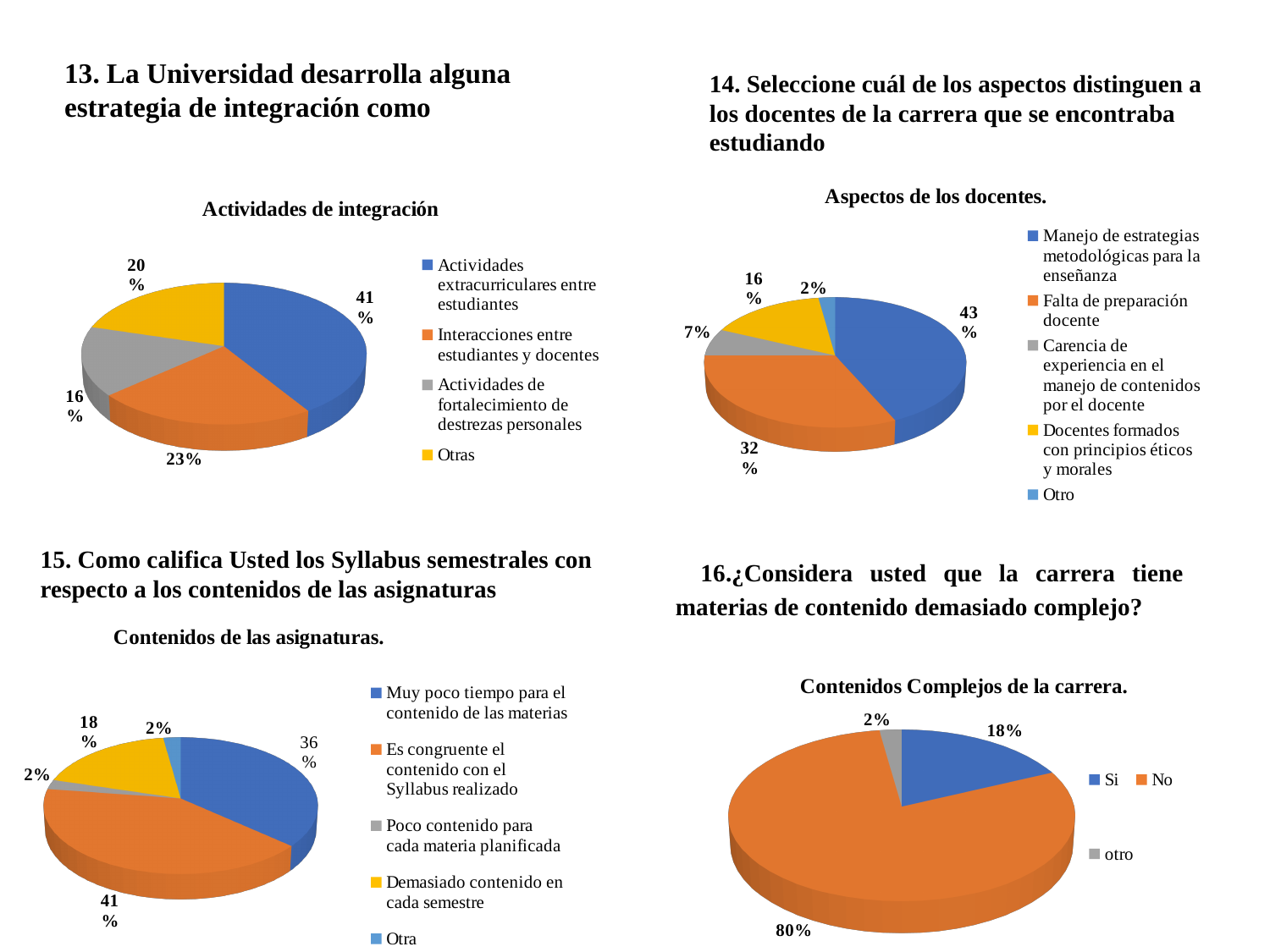
In the 'Contenidos Complejos de la carrera.' chart, what share is labelled for 'No'? 80% In the 'Contenidos de las asignaturas.' chart, which is larger: 'Muy poco tiempo para el contenido de las materias' or 'Es congruente el contenido con el Syllabus realizado'? Es congruente el contenido con el Syllabus realizado In the 'Contenidos Complejos de la carrera.' chart, what is the difference between the 'No' slice and the 'Si' slice? 62% In the 'Actividades de integración' chart, what share is labelled for 'Actividades extracurriculares entre estudiantes'? 41% In the 'Actividades de integración' chart, what is the difference between the 'Interacciones entre estudiantes y docentes' slice and the 'Otras' slice? 3% In the 'Actividades de integración' chart, which category has the smallest slice? Actividades de fortalecimiento de destrezas personales What kind of chart is used for 'Contenidos Complejos de la carrera.'? Pie chart In the 'Contenidos de las asignaturas.' chart, what share is labelled for 'Demasiado contenido en cada semestre'? 18% In the 'Aspectos de los docentes.' chart, which category has the largest slice? Manejo de estrategias metodológicas para la enseñanza How many pie charts are shown on the slide? 4 How many categories does the legend of the 'Aspectos de los docentes.' chart list? 5